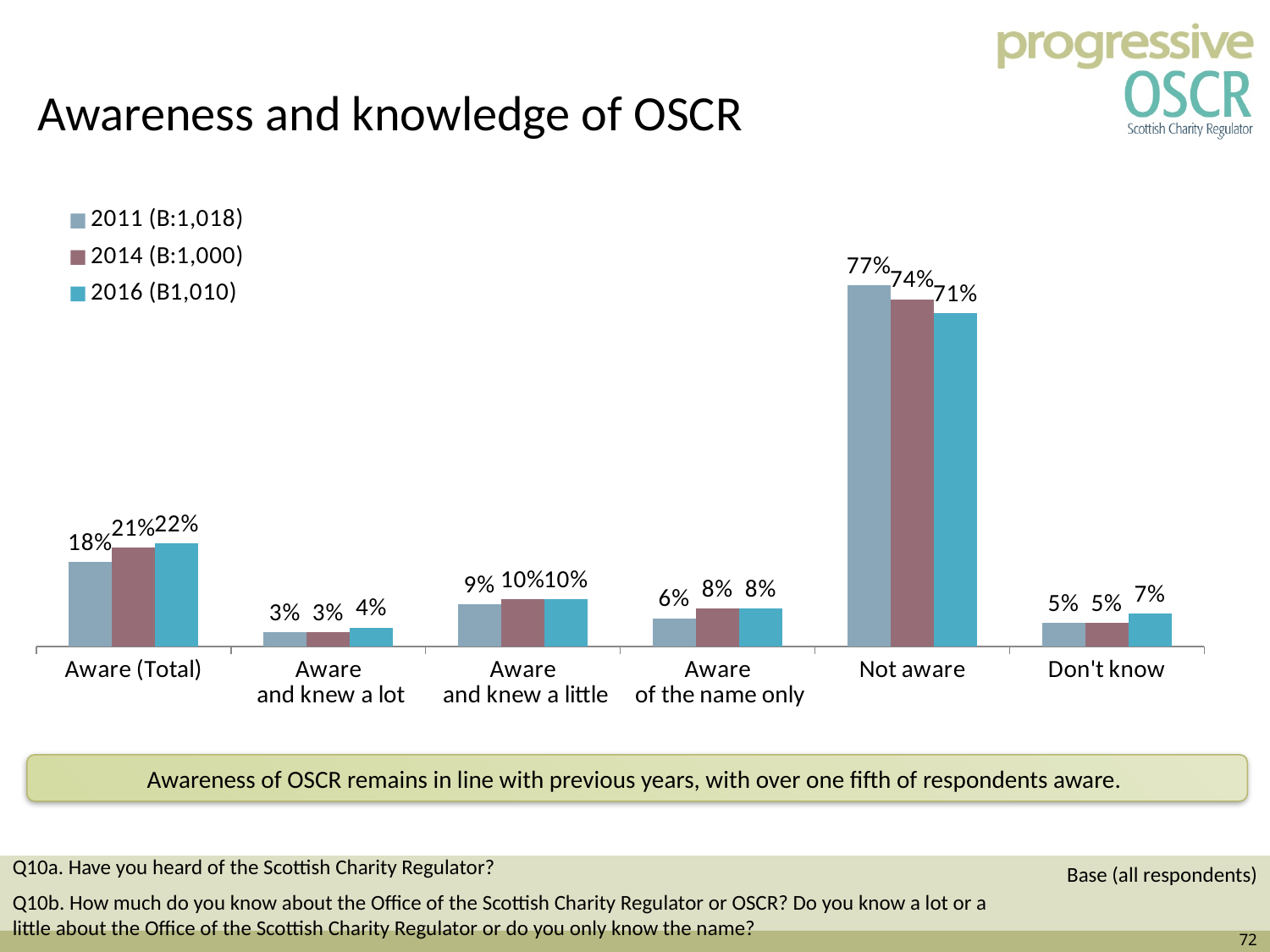
Which category has the lowest value in the 2011 (B:1,018) series? Aware and knew a lot What is the value for 'Aware (Total)' in the 2016 (B1,010) series? 22% Which category has the highest value in the 2016 (B1,010) series? Not aware What is the value for 'Not aware' in the 2011 (B:1,018) series? 77% What kind of chart is shown on the slide? Bar chart Which is larger for 'Aware of the name only': the 2011 (B:1,018) value or the 2014 (B:1,000) value? 2014 (B:1,000) What is the value for 'Aware and knew a lot' in the 2014 (B:1,000) series? 3% What is the value for 'Don't know' in the 2016 (B1,010) series? 7% Does the value for 'Not aware' rise or fall from 2011 to 2016? Fall How many categories are shown on the x axis? 6 How many series does the legend list? 3 What is the difference between the 2011 (B:1,018) and 2016 (B1,010) values for 'Not aware'? 6%